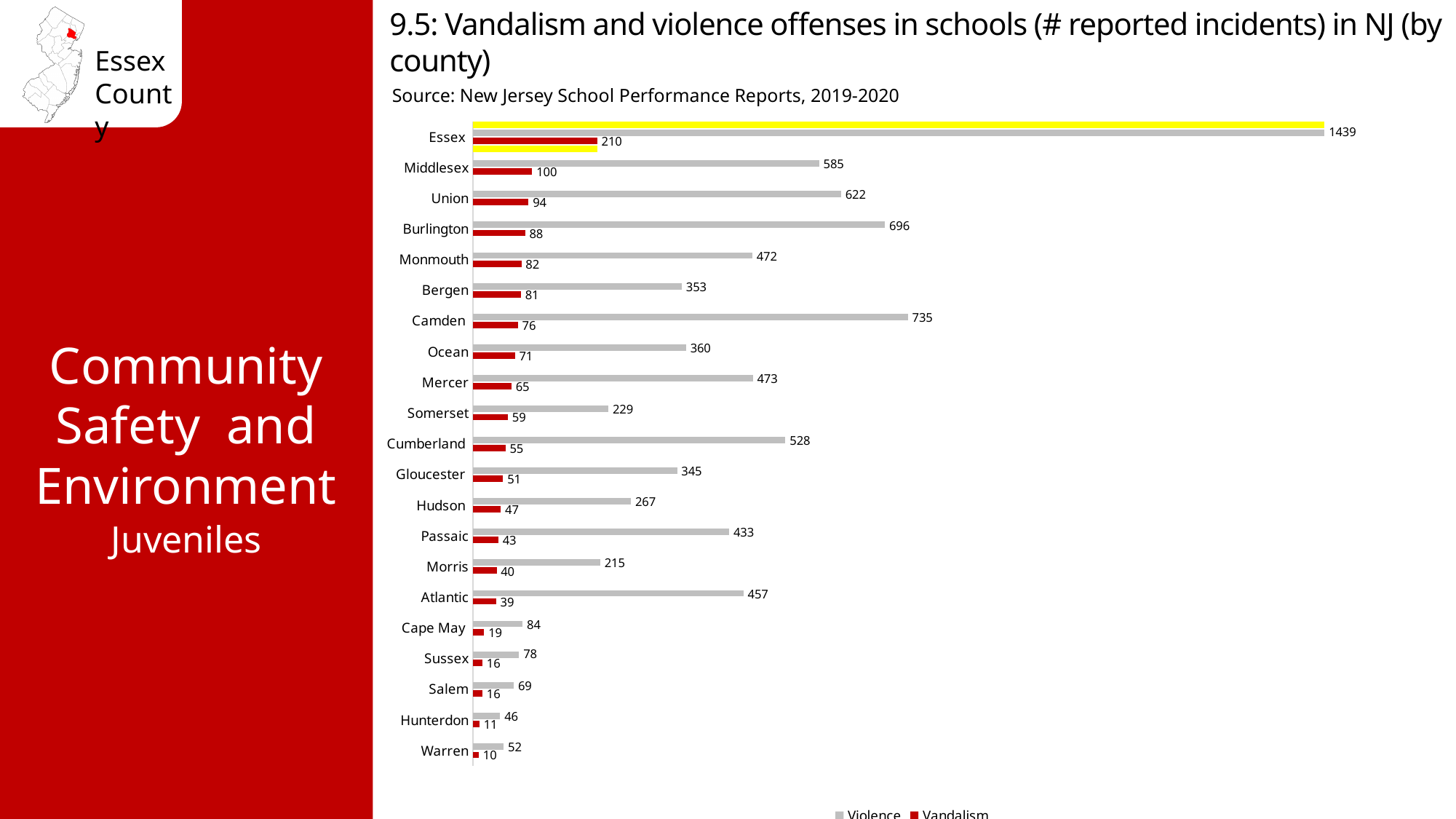
What is the number of reported violence incidents in Camden County? 735 Which county has more reported violence incidents, Union or Middlesex? Union What is the difference between the violence and vandalism incidents in Essex County? 1229 What is the number of reported vandalism incidents in Middlesex County? 100 How many series does the legend list? 2 Which county has the lowest number of reported vandalism incidents? Warren What is the difference in vandalism incidents between Burlington and Monmouth? 6 How many counties are shown in the chart? 21 What kind of chart is shown on the slide? Bar chart What is the number of reported violence incidents in Essex County? 1439 Which series is shown in red in the chart? Vandalism Which county has the highest number of reported violence incidents? Essex